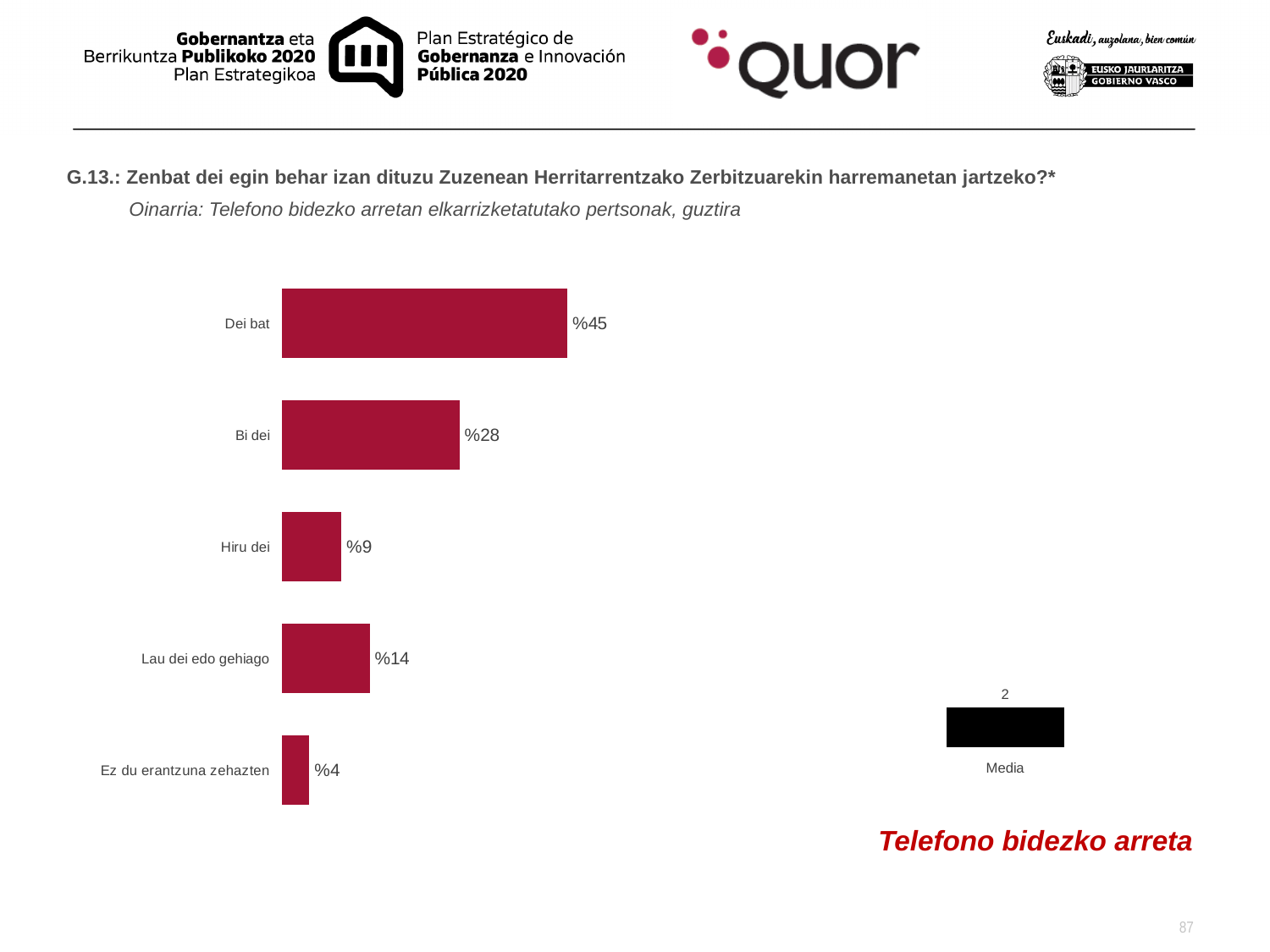
What is the difference between the values for "Dei bat" and "Bi dei"? %17 What is the value for "Bi dei"? %28 Which category has the highest value? Dei bat What is the value for "Lau dei edo gehiago"? %14 How many categories are shown in the main bar chart? 5 What is the red text label shown at the bottom right of the slide? Telefono bidezko arreta What is the value for "Ez du erantzuna zehazten"? %4 Which category has the lowest value? Ez du erantzuna zehazten What value is shown for "Media" in the small chart on the right? 2 What kind of chart is used to show the categories? Bar chart Which is larger, the value for "Hiru dei" or the value for "Lau dei edo gehiago"? Lau dei edo gehiago What is the value for "Dei bat"? %45